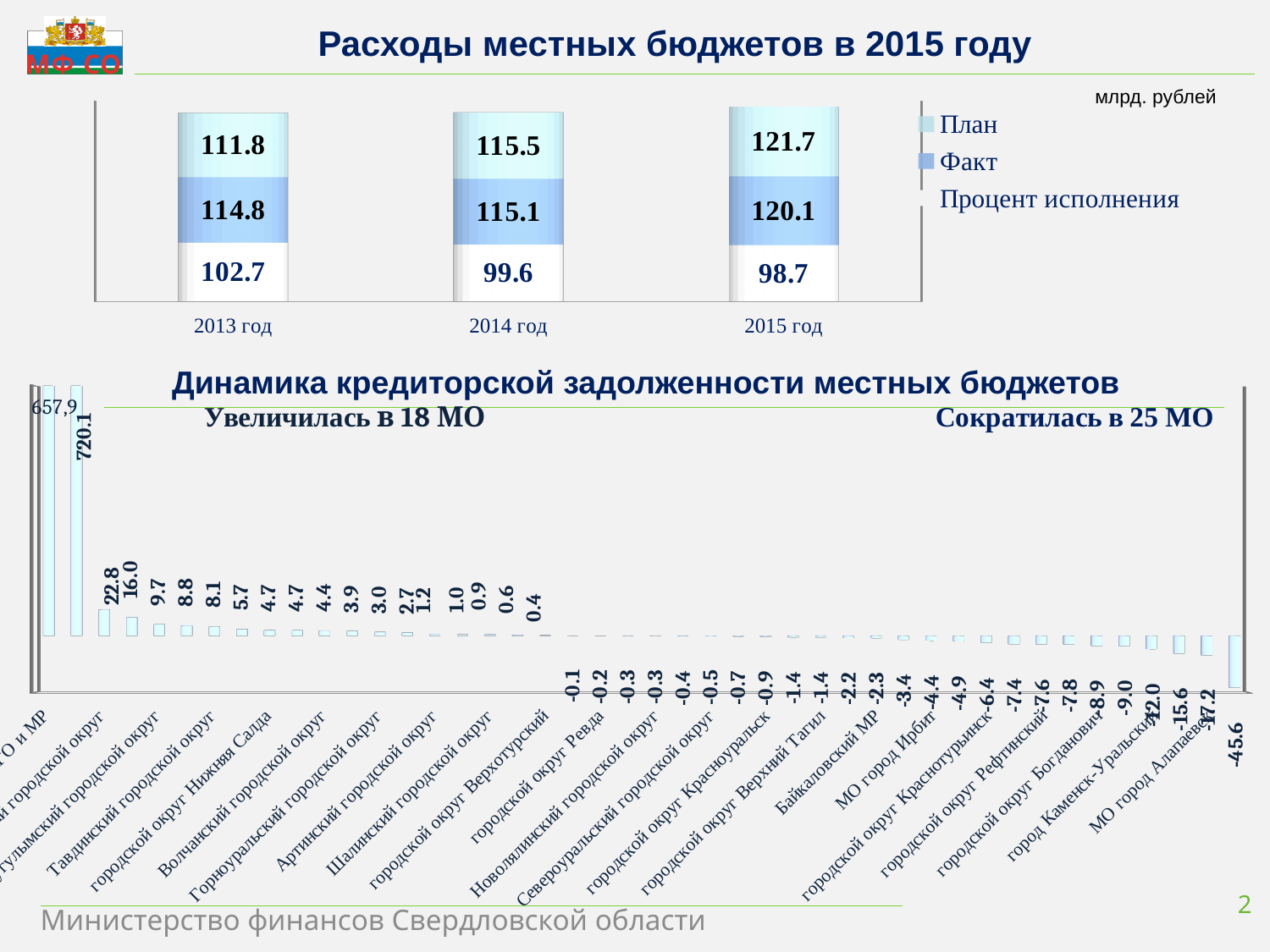
In the top chart 'Расходы местных бюджетов в 2015 году', what is the Факт value for 2013 год? 114.8 In the bottom chart 'Динамика кредиторской задолженности местных бюджетов', what is the highest value shown? 720.1 In the top chart 'Расходы местных бюджетов в 2015 году', what is the Процент исполнения for 2014 год? 99.6 In the top chart 'Расходы местных бюджетов в 2015 году', how does the План value change from 2013 год to 2015 год? It rises In the bottom chart 'Динамика кредиторской задолженности местных бюджетов', what is the lowest value shown? -45.6 What kind of chart is the bottom chart 'Динамика кредиторской задолженности местных бюджетов'? Bar chart In the top chart 'Расходы местных бюджетов в 2015 году', is the Факт value for 2014 год larger or smaller than the Факт value for 2015 год? smaller In the top chart 'Расходы местных бюджетов в 2015 году', which year has the lowest Процент исполнения? 2015 год In the top chart 'Расходы местных бюджетов в 2015 году', what is the difference between the План values for 2015 год and 2013 год? 9.9 In the top chart 'Расходы местных бюджетов в 2015 году', which year has the highest План value? 2015 год In the top chart 'Расходы местных бюджетов в 2015 году', how many series does the legend list? 3 In the top chart 'Расходы местных бюджетов в 2015 году', what is the План value for 2015 год? 121.7